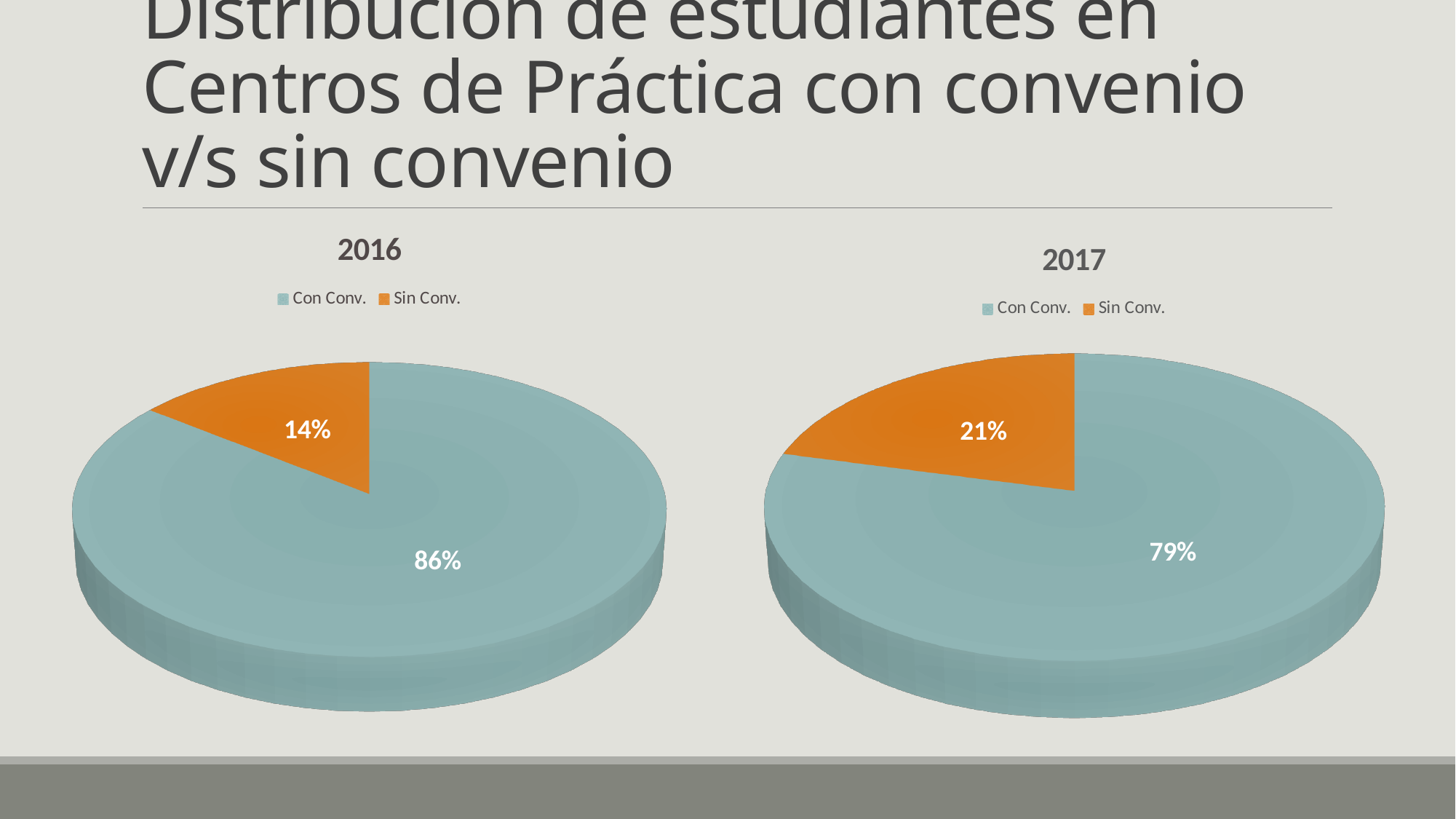
In the 2016 chart, what is the difference in percentage points between Con Conv. and Sin Conv.? 72 In the 2017 chart, what share of students is labelled for Con Conv.? 79% In the 2017 chart, which category has the smallest slice? Sin Conv. In the 2016 chart, what share of students is labelled for Sin Conv.? 14% How many slices does the 2017 pie chart have? 2 How many categories does the legend of the 2016 chart list? 2 In the 2016 chart, which category has the largest slice? Con Conv. Comparing the Sin Conv. slices, is the 2017 value larger or smaller than the 2016 value? larger What type of chart is the 2017 chart? pie chart What colour is the Sin Conv. slice in the 2016 chart? orange In the 2016 chart, what share of students is labelled for Con Conv.? 86% In the 2017 chart, what share of students is labelled for Sin Conv.? 21%